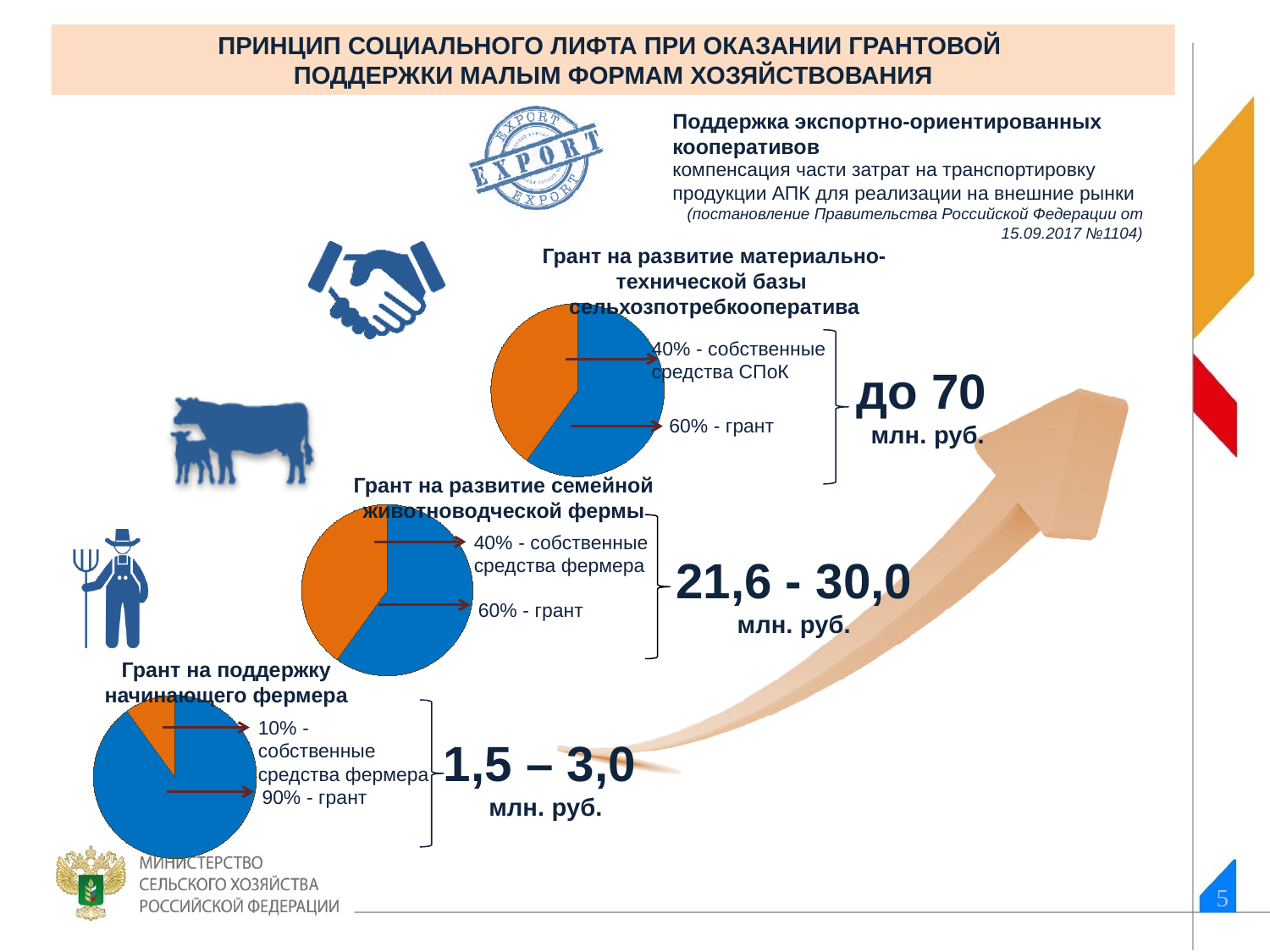
In the pie chart "Грант на поддержку начинающего фермера", what share is the farmer's own funds (собственные средства фермера)? 10% In the pie chart "Грант на развитие семейной животноводческой фермы", which slice is the smallest? собственные средства фермера How many slices does the pie chart "Грант на развитие семейной животноводческой фермы" have? 2 How many pie charts are shown on the slide? 3 In the pie chart "Грант на поддержку начинающего фермера", what share is the grant (грант)? 90% What kind of chart is used for "Грант на поддержку начинающего фермера"? pie chart In the pie chart "Грант на поддержку начинающего фермера", which slice is larger: the grant or the farmer's own funds? грант In the pie chart "Грант на поддержку начинающего фермера", what colour is the grant (90%) slice? blue In the pie chart "Грант на развитие семейной животноводческой фермы", what share is the farmer's own funds (собственные средства фермера)? 40%